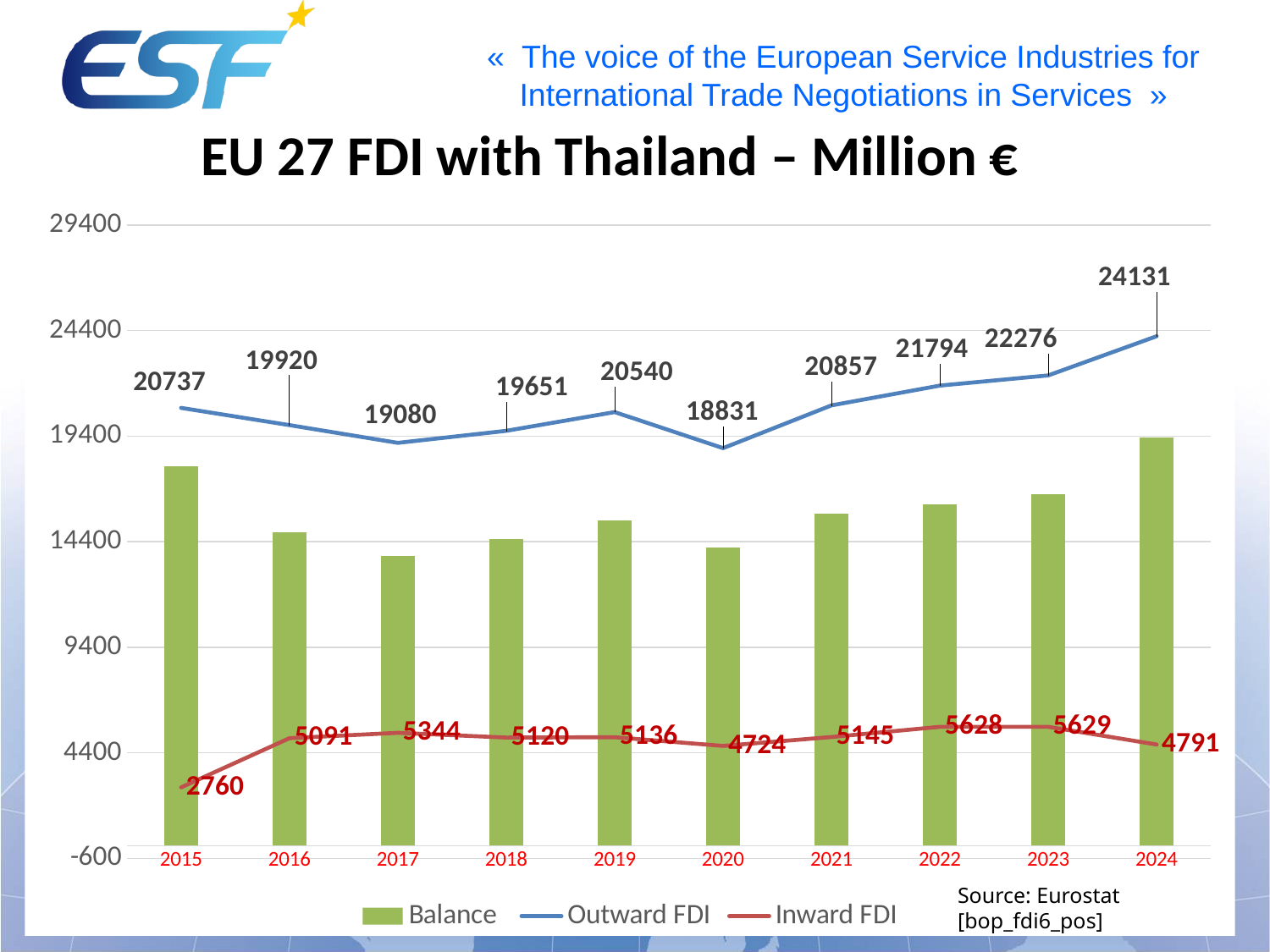
Is the Balance value for 2015 greater or less than 14400? greater What is the Outward FDI value for 2024? 24131 What is the difference between Outward FDI in 2024 and in 2023? 1855 What is the Inward FDI value for 2015? 2760 Does Outward FDI rise or fall from 2020 to 2024? Rise In which year is Inward FDI lowest? 2015 What kind of chart is this? Combined bar and line chart How many years are shown on the x axis? 10 Which is larger, Inward FDI in 2017 or in 2018? 2017 In which year is Outward FDI lowest? 2020 How many series does the legend list? 3 In which year is Outward FDI highest? 2024